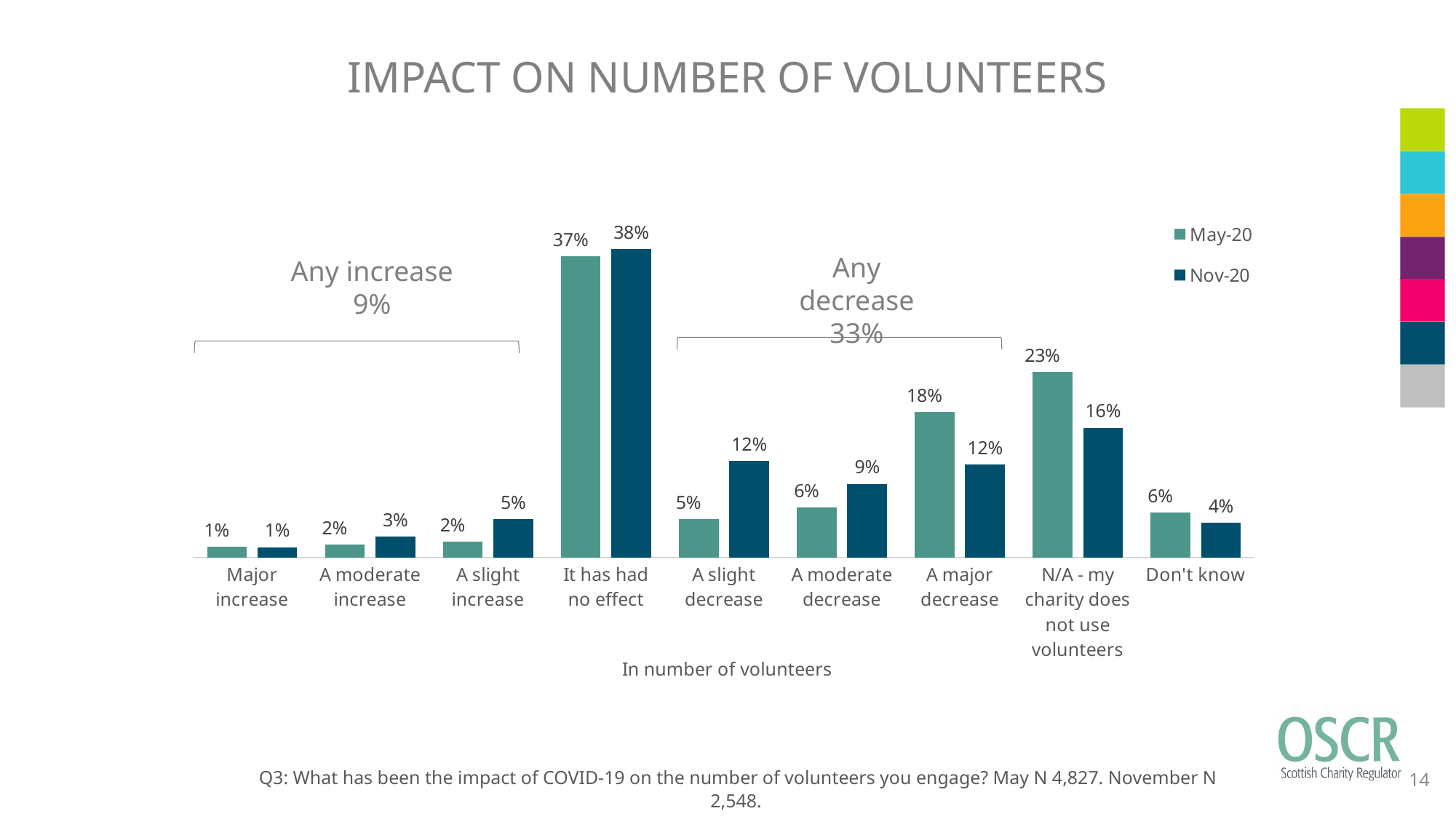
How many series does the legend list? 2 Which category has the highest May-20 value? It has had no effect What is the May-20 value for 'N/A - my charity does not use volunteers'? 23% What kind of chart is shown on the slide? Bar chart Which category has the lowest Nov-20 value? Major increase Which is larger for 'A major decrease': the May-20 value or the Nov-20 value? May-20 What is the Nov-20 value for 'It has had no effect'? 38% What is the title of the chart? IMPACT ON NUMBER OF VOLUNTEERS How many categories are shown on the x axis? 9 What is the difference between the May-20 and Nov-20 values for 'N/A - my charity does not use volunteers'? 7% What is the Nov-20 value for 'A slight decrease'? 12% What percentage is labelled for 'Any decrease' on the chart? 33%